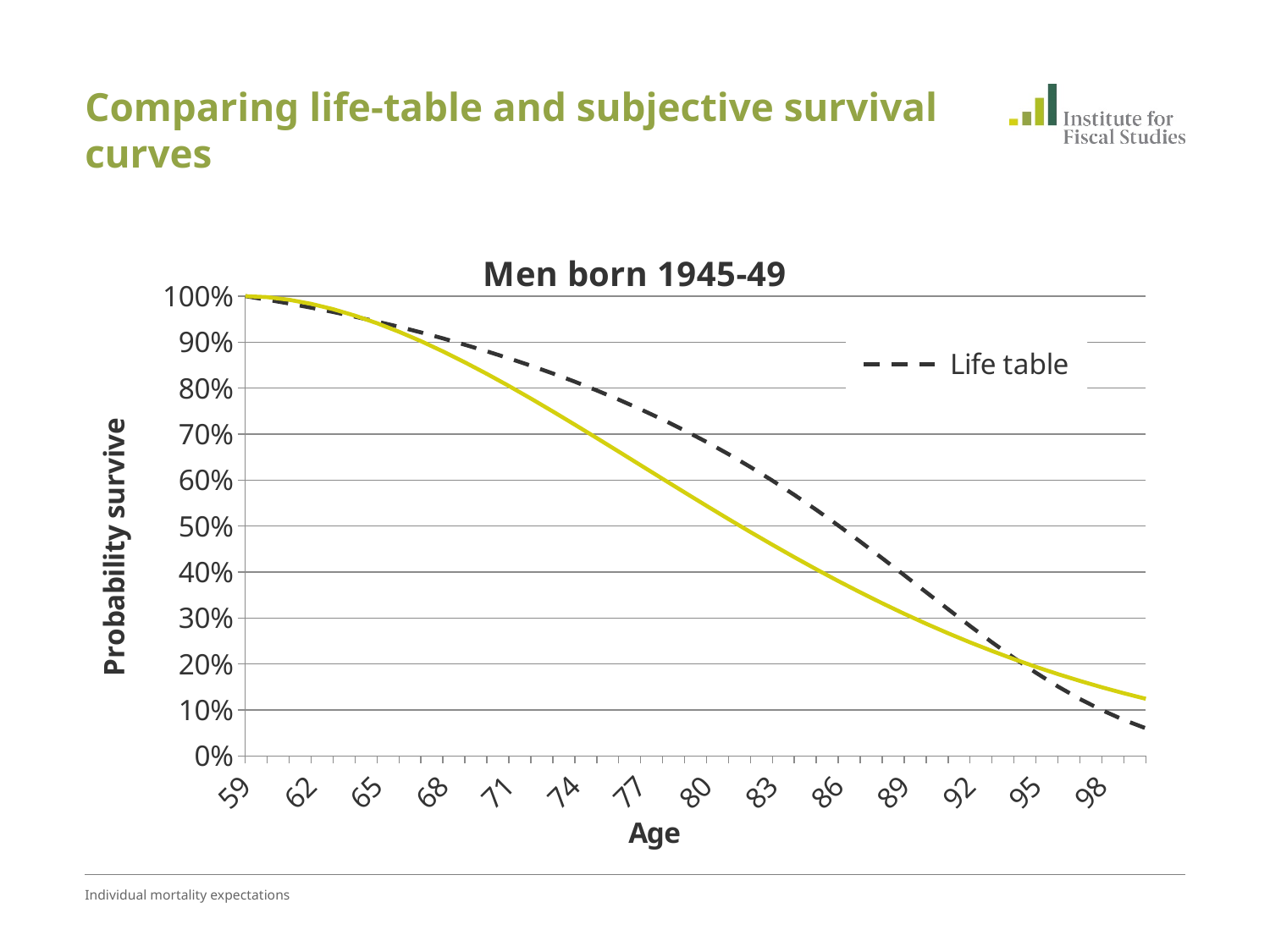
Is the value of the solid line at age 65 greater or less than 90%? greater What is the value of the Life table line at age 59? 100% At age 80, which line is higher: the dashed Life table line or the solid line? Life table What is the title of the chart? Men born 1945-49 What is the label of the y axis? Probability survive Is the Life table value at age 77 greater or less than 70%? greater How many series does the chart's legend list? 1 Is the value of the solid line at age 68 greater or less than 90%? less What kind of chart is shown on the slide? line chart At age 98, which line is higher: the dashed Life table line or the solid line? the solid line Do the survival probabilities rise or fall as age increases along the x axis? fall